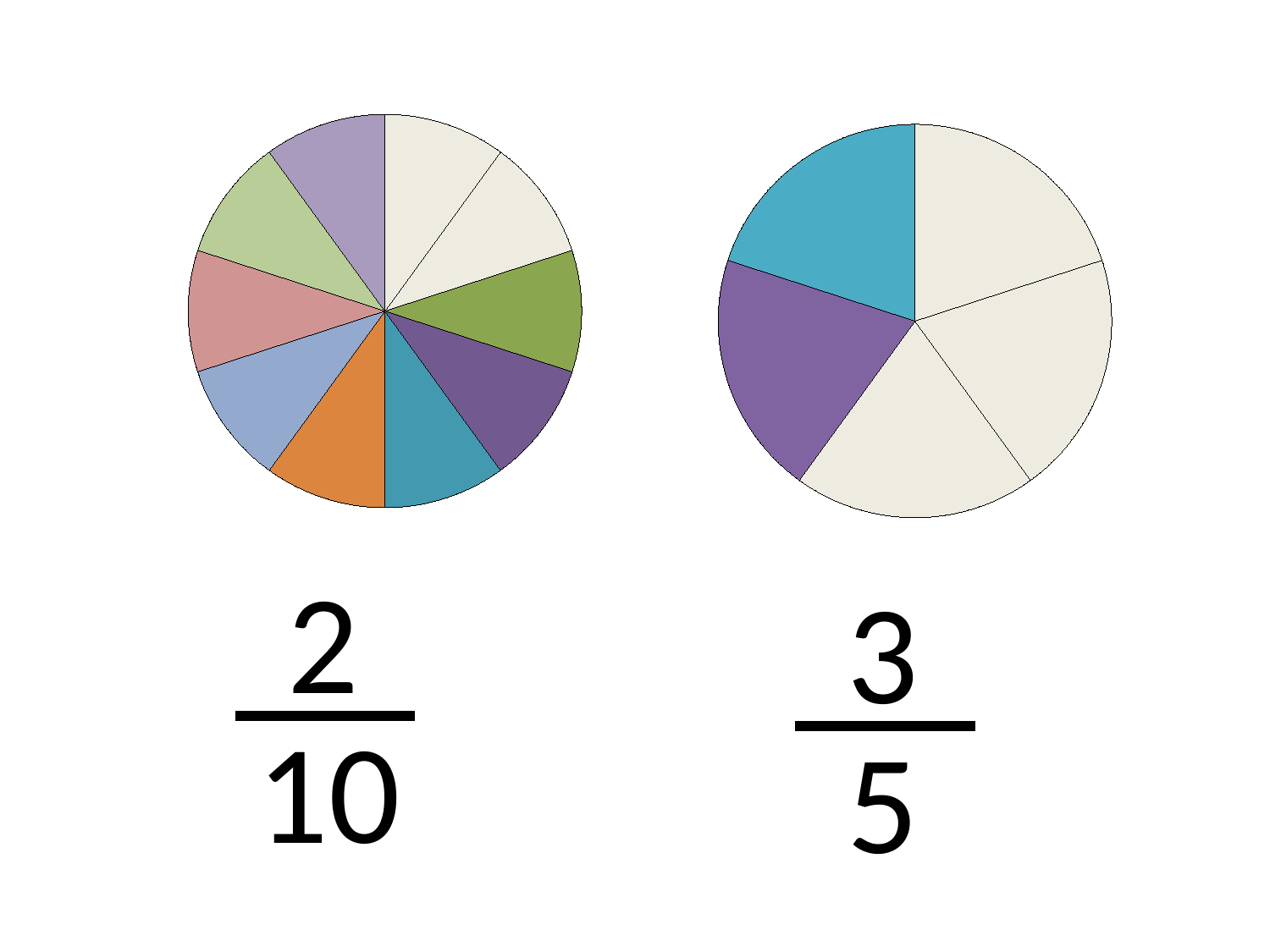
According to the fraction printed below it, what share of the left pie chart do the unshaded slices represent? 2/10 How many pie charts are on the slide? 2 In the right pie chart, how many slices are coloured (not cream)? 2 In the right pie chart, how many slices are unshaded (cream coloured)? 3 Which pie chart has more slices, the left one or the right one? the left one What fraction is written below the right pie chart? 3/5 What kind of chart is shown on the right of the slide? pie chart What kind of chart is shown on the left of the slide? pie chart What fraction is written below the left pie chart? 2/10